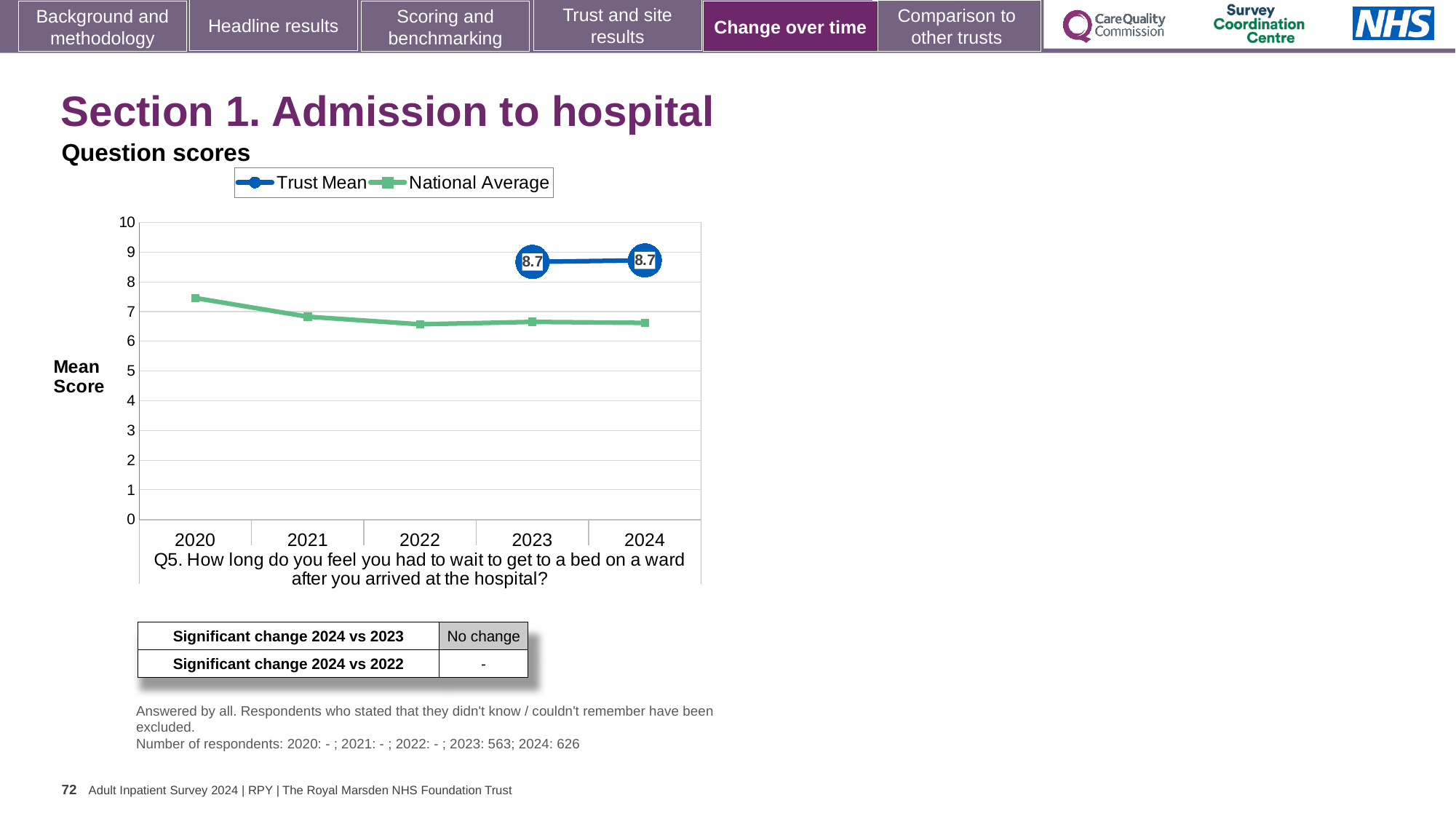
Is the National Average value for 2022 greater or less than 7? less In which year is the National Average at its highest? 2020 What is the Trust Mean score for 2023? 8.7 Which survey question does the chart relate to? Q5. How long do you feel you had to wait to get to a bed on a ward after you arrived at the hospital? What kind of chart is shown on the slide? line chart What is the Trust Mean score for 2024? 8.7 Does the National Average rise or fall from 2020 to 2022? fall Is the National Average value for 2020 greater or less than 7? greater How many years are shown along the x axis? 5 What is the difference between the Trust Mean in 2024 and in 2023? 0 How many series does the legend list? 2 In 2024, which is higher: the Trust Mean or the National Average? Trust Mean